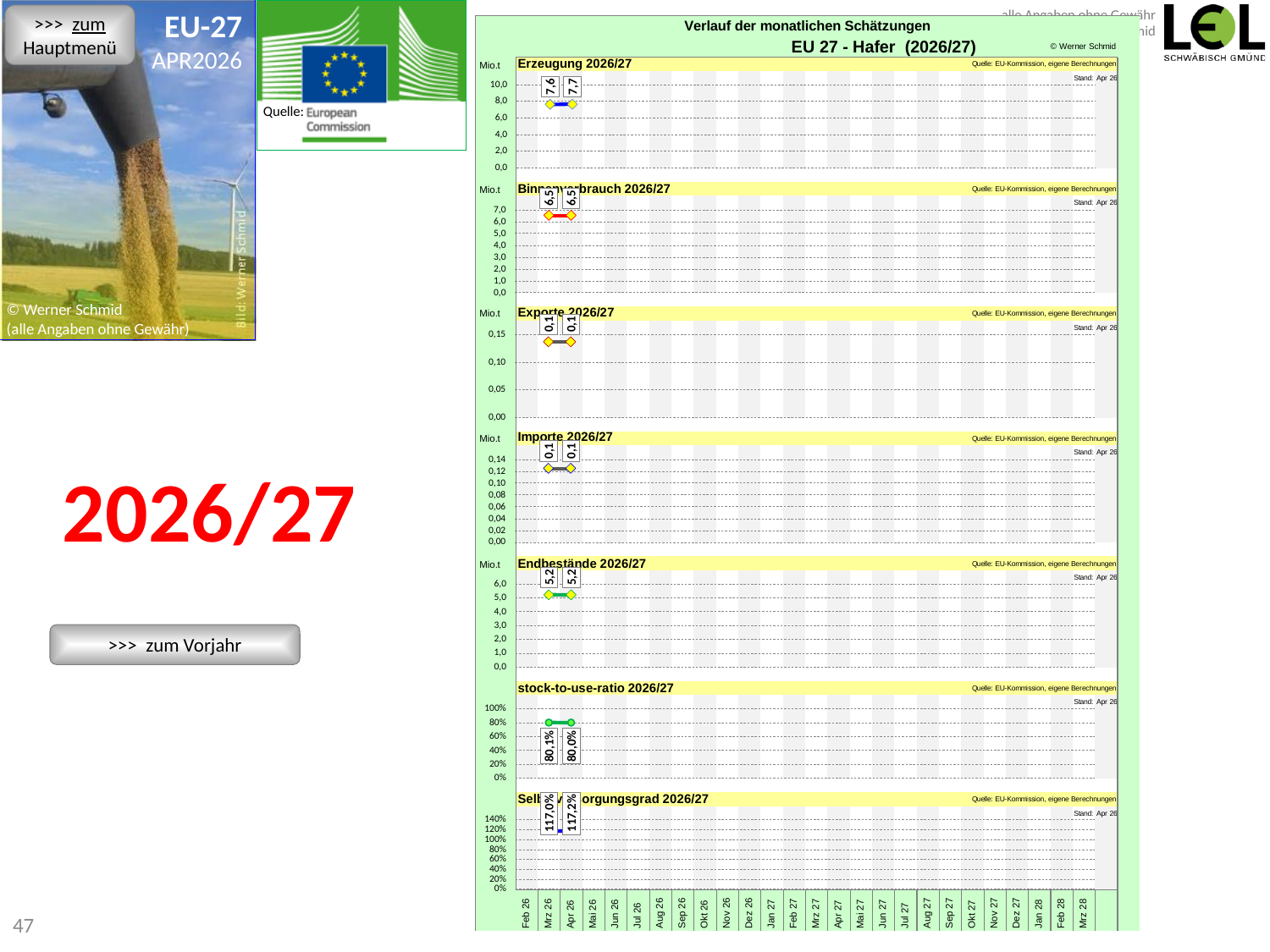
In the 'Endbestände 2026/27' chart, what is the value for Mrz 26? 5,2 In the 'stock-to-use-ratio 2026/27' chart, what is the value for Apr 26? 80,0% What kind of chart is the 'Endbestände 2026/27' chart? line chart In the 'Selbstversorgungsgrad 2026/27' chart, what is the value for Mrz 26? 117,0% In the 'Erzeugung 2026/27' chart, what is the value for Mrz 26? 7,6 In the 'Erzeugung 2026/27' chart, what is the value for Apr 26? 7,7 In the 'Erzeugung 2026/27' chart, what is the difference between the Apr 26 and Mrz 26 values? 0,1 In the 'Binnenverbrauch 2026/27' chart, what is the value for Apr 26? 6,5 In the 'Erzeugung 2026/27' chart, do the values rise or fall from Mrz 26 to Apr 26? rise In the 'Selbstversorgungsgrad 2026/27' chart, which is larger, the Mrz 26 value or the Apr 26 value? Apr 26 In the 'Exporte 2026/27' chart, what is the value for Apr 26? 0,1 How many data points are plotted in the 'Importe 2026/27' chart? 2